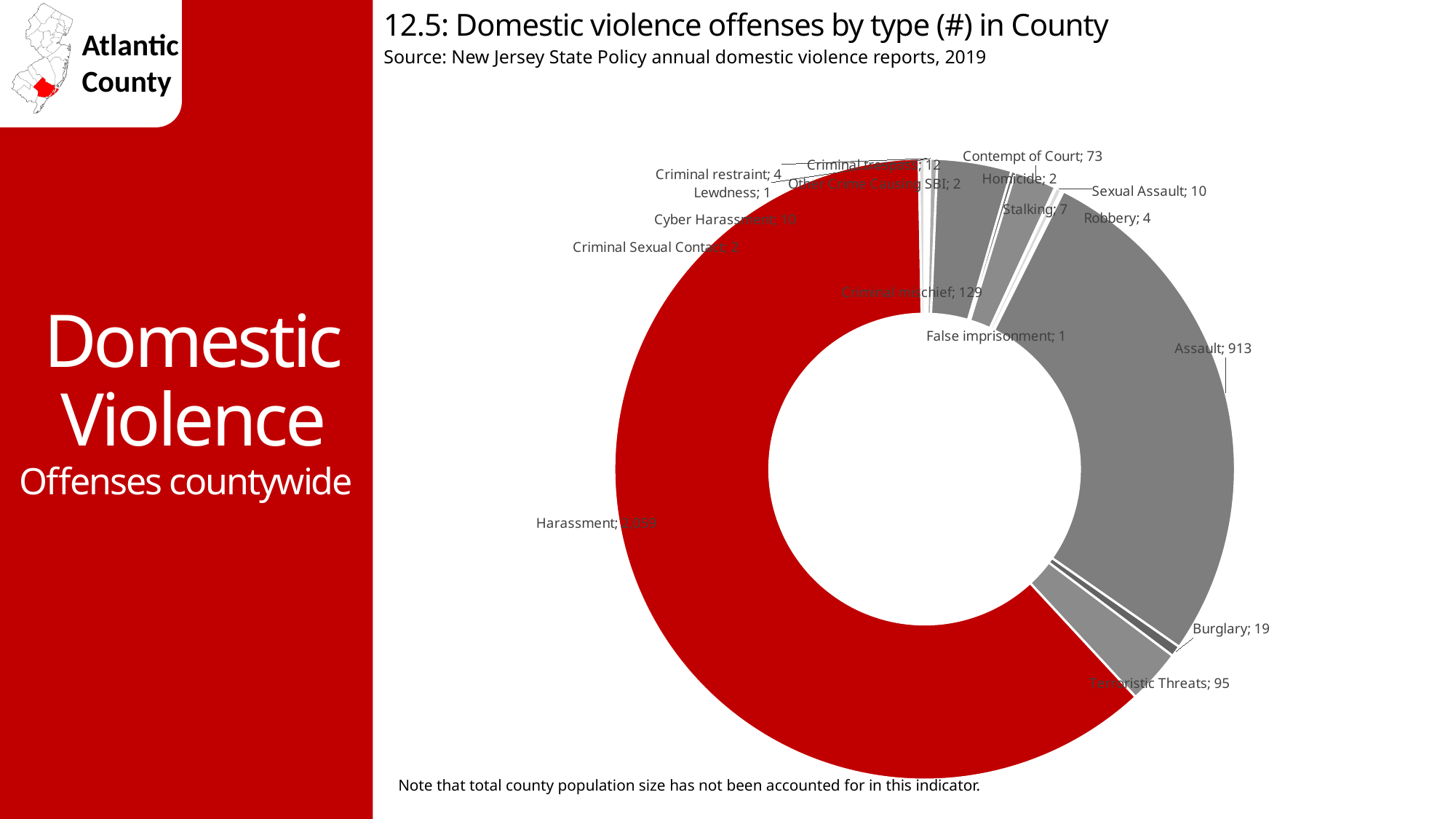
What year of reports does the chart's source cite? 2019 What is the value shown for Sexual Assault? 10 Which is larger, the value for Assault or the value for Terroristic Threats? Assault What is the value shown for Burglary? 19 What is the value shown for Terroristic Threats? 95 What is the difference between the values for Criminal mischief and Contempt of Court? 56 How many domestic violence offenses of type Assault are shown on the chart? 913 What is the value shown for Contempt of Court? 73 What kind of chart is shown on the slide? doughnut chart What is the value shown for Criminal mischief? 129 What is the difference between the values for Assault and Terroristic Threats? 818 Which offense type has the largest slice of the chart? Harassment